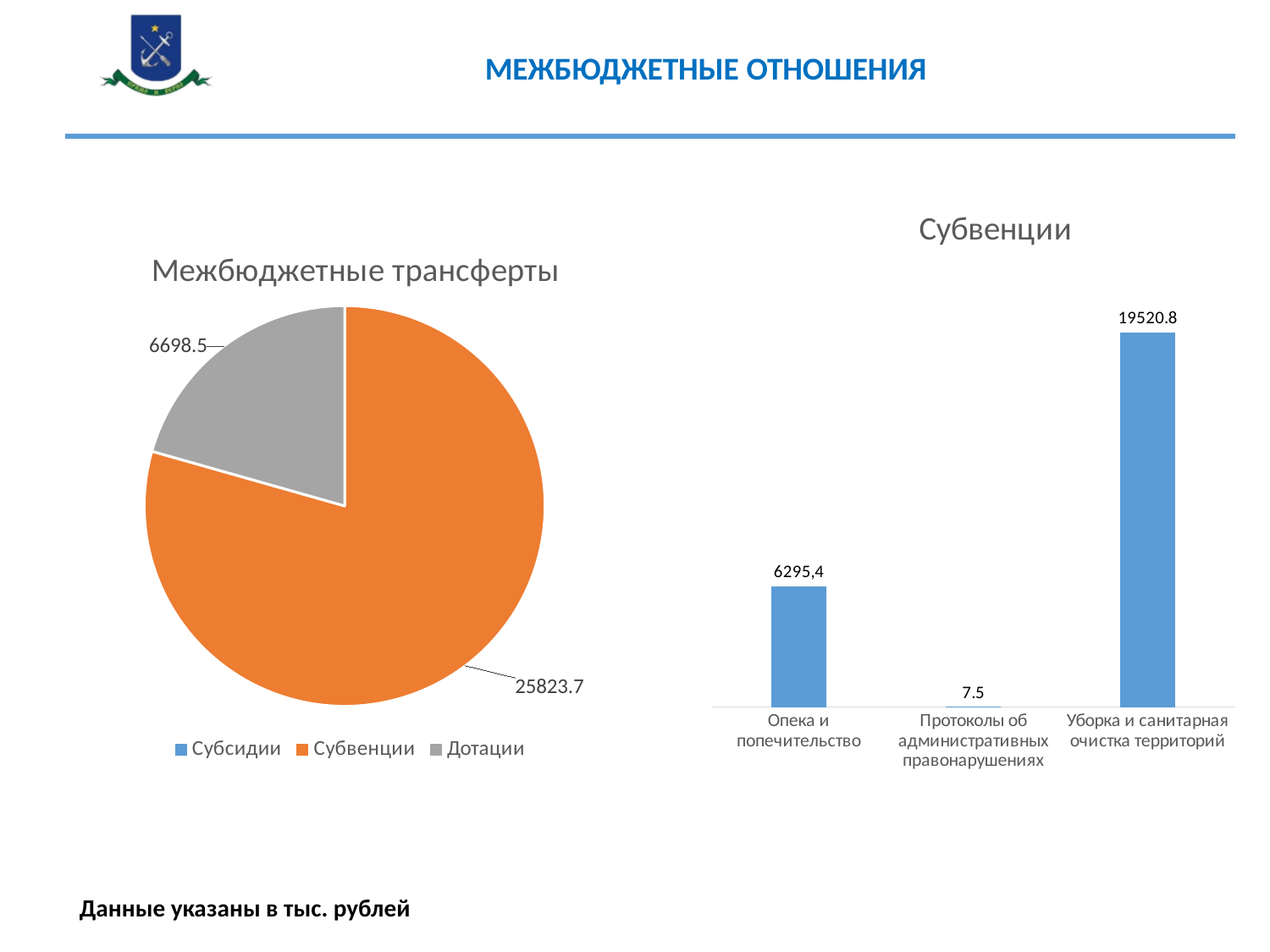
In the 'Субвенции' bar chart, what is the value for 'Опека и попечительство'? 6295,4 What type of chart is the 'Субвенции' chart on the right? bar chart In the 'Межбюджетные трансферты' pie chart, what value is shown for the Субвенции slice? 25823.7 In the 'Межбюджетные трансферты' pie chart, which category has the largest slice? Субвенции In the 'Субвенции' bar chart, what is the value for 'Уборка и санитарная очистка территорий'? 19520.8 In the 'Субвенции' bar chart, what is the difference between 'Уборка и санитарная очистка территорий' and 'Опека и попечительство'? 13225.4 In the 'Субвенции' bar chart, which category has the lowest value? Протоколы об административных правонарушениях In the 'Межбюджетные трансферты' pie chart, what value is shown for the Дотации slice? 6698.5 In the 'Субвенции' bar chart, how many categories are shown? 3 How many entries does the legend of the 'Межбюджетные трансферты' pie chart list? 3 What type of chart is the 'Межбюджетные трансферты' chart on the left? pie chart In the 'Субвенции' bar chart, what is the value for 'Протоколы об административных правонарушениях'? 7.5